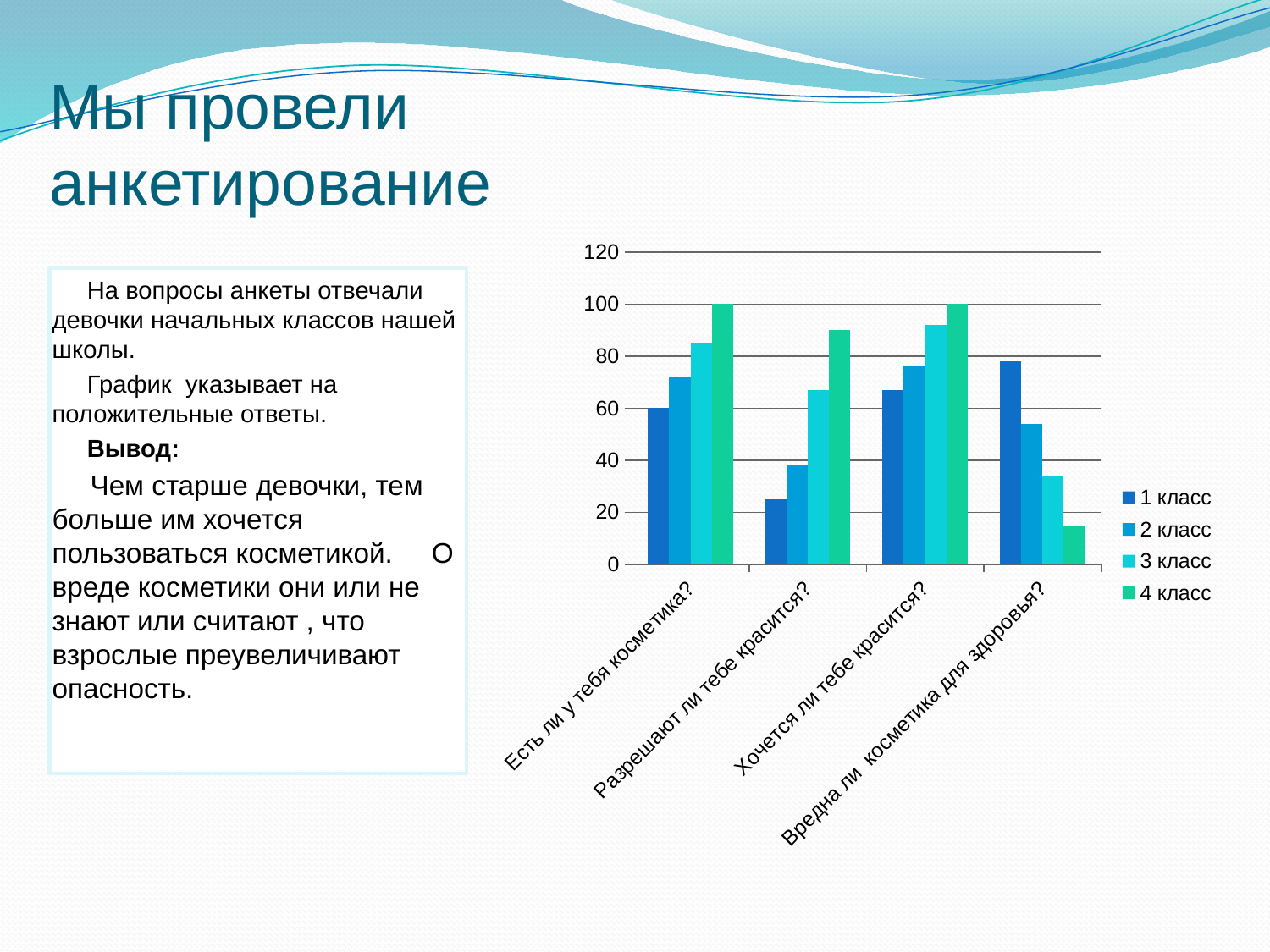
What is the value for 4 класс for "Есть ли у тебя косметика?"? 100 Which series has the highest value for "Разрешают ли тебе краситься?"? 4 класс Which is larger for "Вредна ли косметика для здоровья?": 1 класс or 2 класс? 1 класс What kind of chart is shown on the slide? bar chart Do the values for "Есть ли у тебя косметика?" rise or fall from 1 класс to 4 класс? rise How many question categories are shown on the x axis? 4 How many series does the legend list? 4 Which legend entry is shown in green? 4 класс Which series has the lowest value for "Вредна ли косметика для здоровья?"? 4 класс What is the value for 4 класс for "Хочется ли тебе краситься?"? 100 Is the value for 3 класс for "Хочется ли тебе краситься?" greater or less than 80? greater Is the value for 1 класс for "Разрешают ли тебе краситься?" greater or less than 40? less